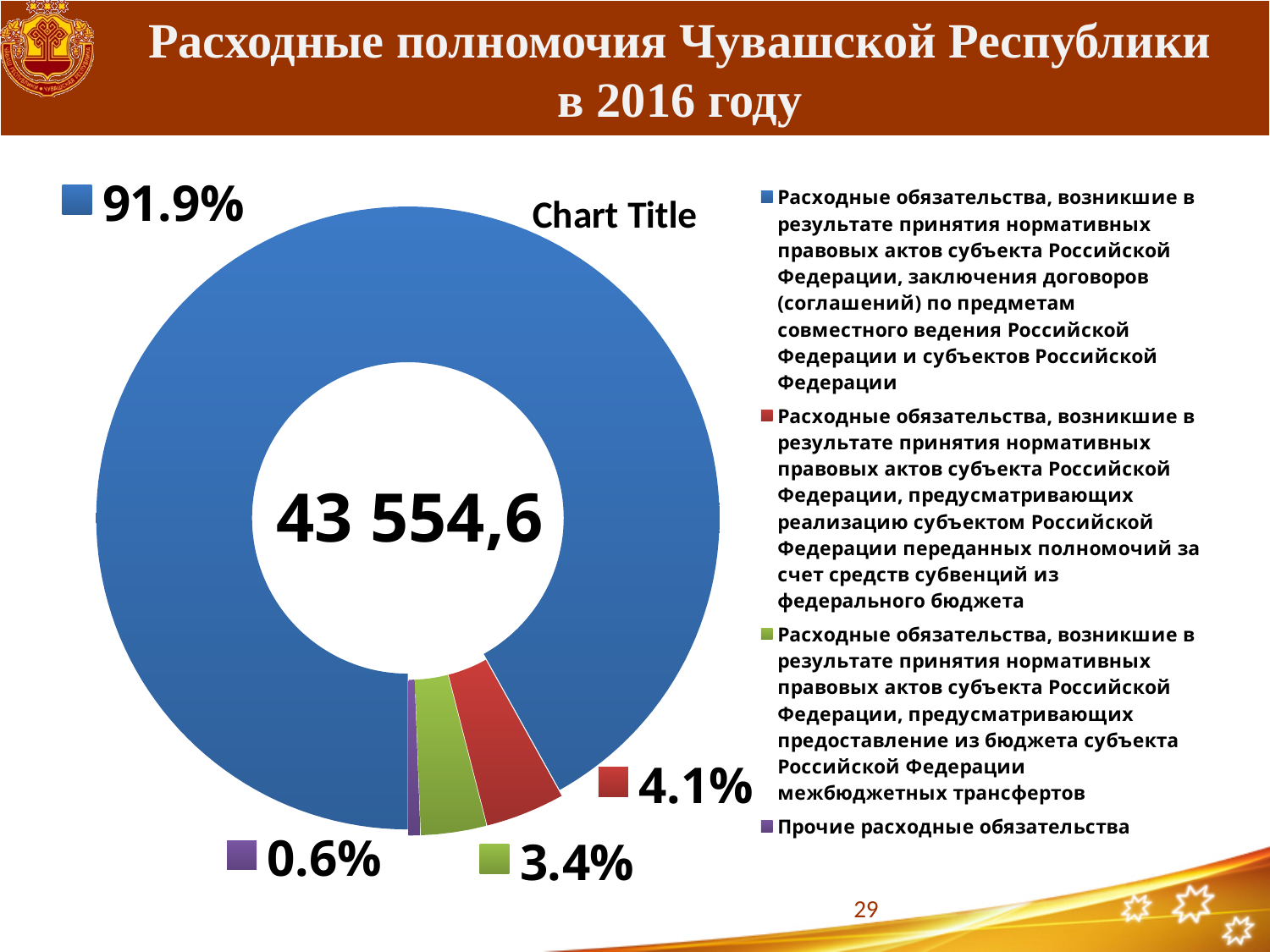
What share does the slice for "Прочие расходные обязательства" have? 0.6% How many entries does the legend list? 4 What is the largest percentage shown on the chart? 91.9% Which legend category has the smallest slice? Прочие расходные обязательства What kind of chart is shown on the slide? doughnut (pie) chart What is the combined share of the three smallest slices (4.1%, 3.4% and 0.6%)? 8.1% Which slice is larger, the red one (4.1%) or the green one (3.4%)? the red one (4.1%) What share does the red slice (expenditure obligations funded by subventions from the federal budget) have? 4.1% What is the difference in percentage points between the red slice (4.1%) and the green slice (3.4%)? 0.7 percentage points What number is printed in the centre of the doughnut chart? 43 554,6 How many slices does the chart have? 4 What share does the green slice (expenditure obligations for inter-budget transfers) have? 3.4%